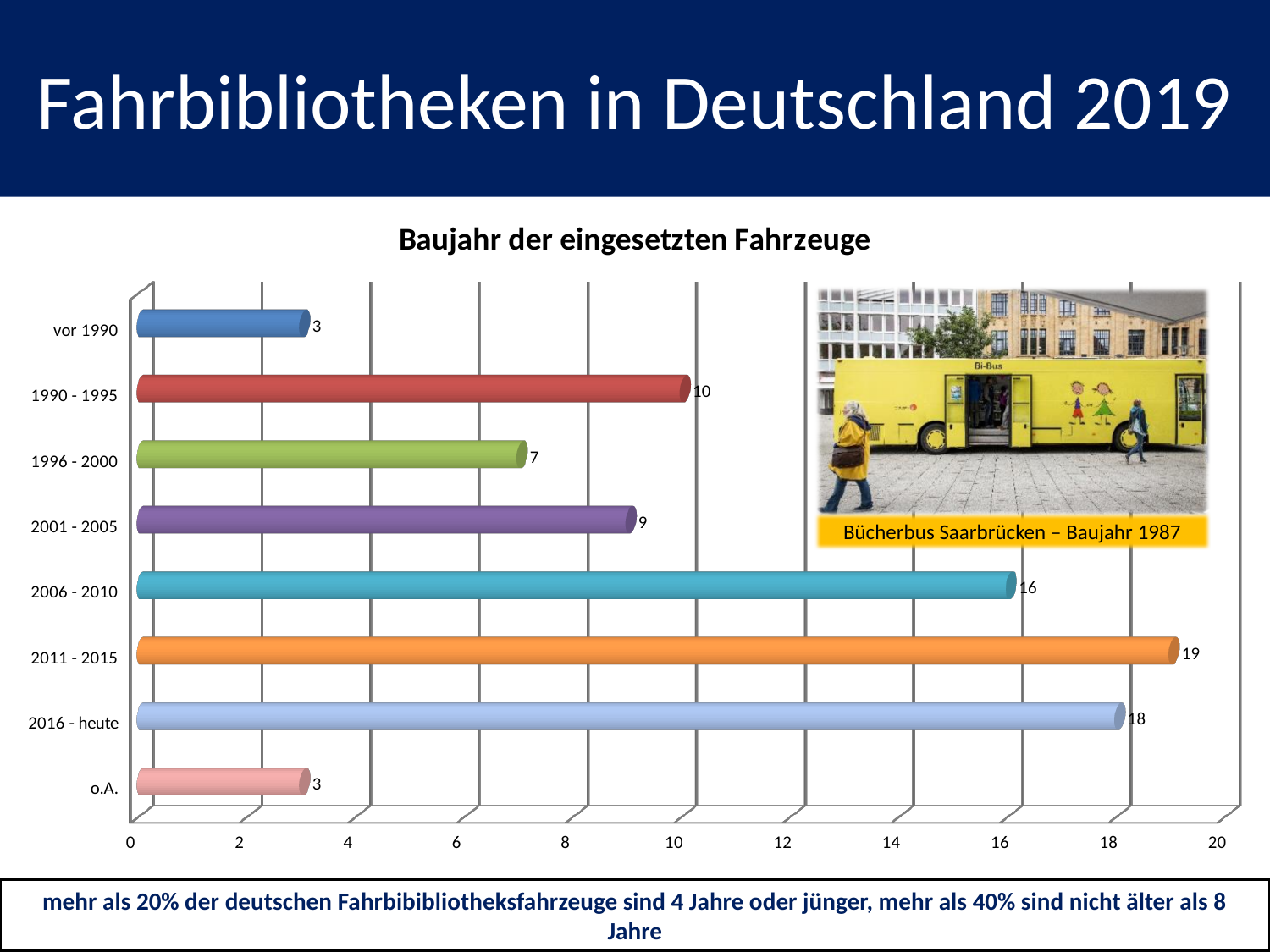
How many categories are shown in the chart? 8 What is the difference between the values for 2011 - 2015 and 2006 - 2010? 3 Which is larger, the value for 1990 - 1995 or the value for 2001 - 2005? 1990 - 1995 What is the value for o.A.? 3 What is the difference between the values for 1990 - 1995 and vor 1990? 7 What is the title of the chart? Baujahr der eingesetzten Fahrzeuge What is the value for 1996 - 2000? 7 What is the value for 2006 - 2010? 16 Is the value for 2016 - heute greater or less than 10? greater What kind of chart is shown on the slide? bar chart What is the value for 2016 - heute? 18 Which category has the highest value? 2011 - 2015